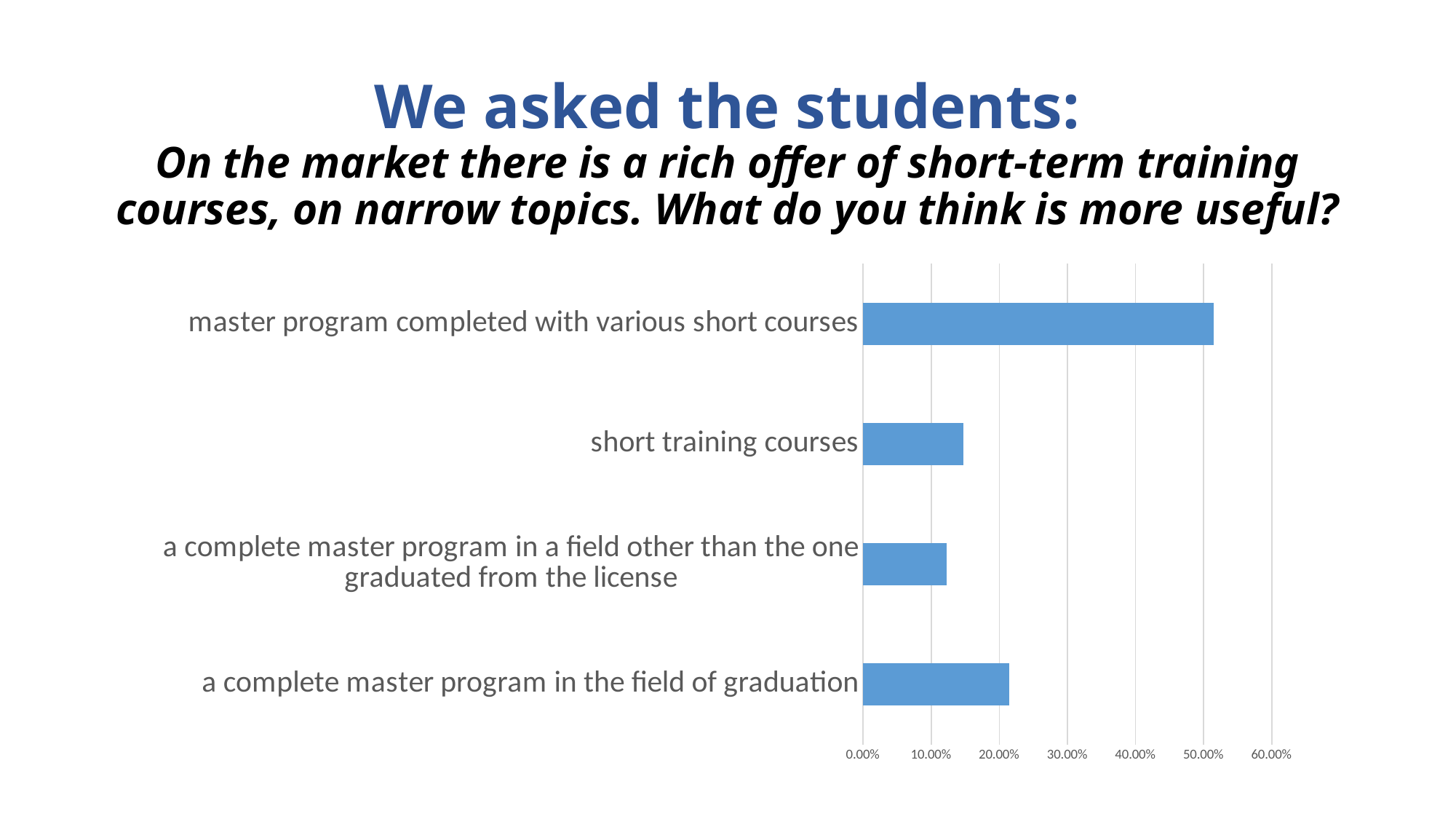
Is the value for 'short training courses' greater or less than 20.00%? less Which category has the lowest value? a complete master program in a field other than the one graduated from the license Is the value for 'a complete master program in the field of graduation' greater or less than 30.00%? less Is the value for 'master program completed with various short courses' greater or less than 40.00%? greater Which is larger: the value for 'a complete master program in the field of graduation' or the value for 'short training courses'? a complete master program in the field of graduation What kind of chart is shown on the slide? bar chart Which category has the highest value? master program completed with various short courses How many categories are shown in the chart? 4 Which is larger: the value for 'master program completed with various short courses' or the value for 'a complete master program in the field of graduation'? master program completed with various short courses What is the maximum value shown on the horizontal axis of the chart? 60.00%